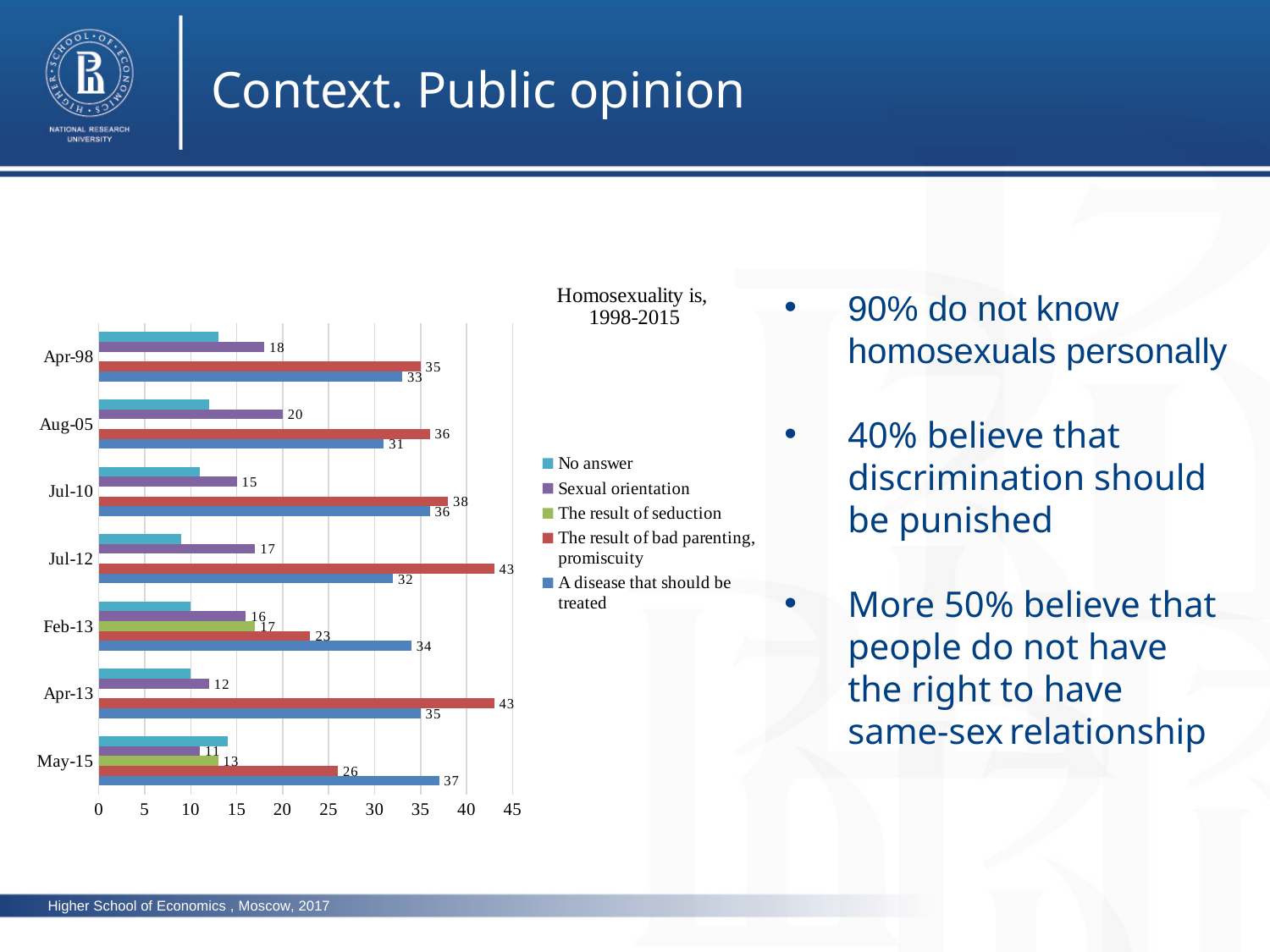
Is the value for 'No answer' in Apr-98 greater or less than 10? greater In Feb-13, which is larger: 'The result of bad parenting, promiscuity' or 'A disease that should be treated'? A disease that should be treated What is the value for 'A disease that should be treated' in May-15? 37 In which period is the value for 'A disease that should be treated' the highest? May-15 What is the value for 'The result of seduction' in Feb-13? 17 In Apr-98, what is the difference between 'The result of bad parenting, promiscuity' and 'A disease that should be treated'? 2 In which period is the value for 'Sexual orientation' the lowest? May-15 What kind of chart is shown on the slide? bar chart In the chart 'Homosexuality is, 1998-2015', what is the value for 'The result of bad parenting, promiscuity' in Jul-12? 43 How many time periods are shown on the chart? 7 From Apr-98 to Jul-12, does the value for 'The result of bad parenting, promiscuity' rise or fall? rise How many series does the legend list? 5